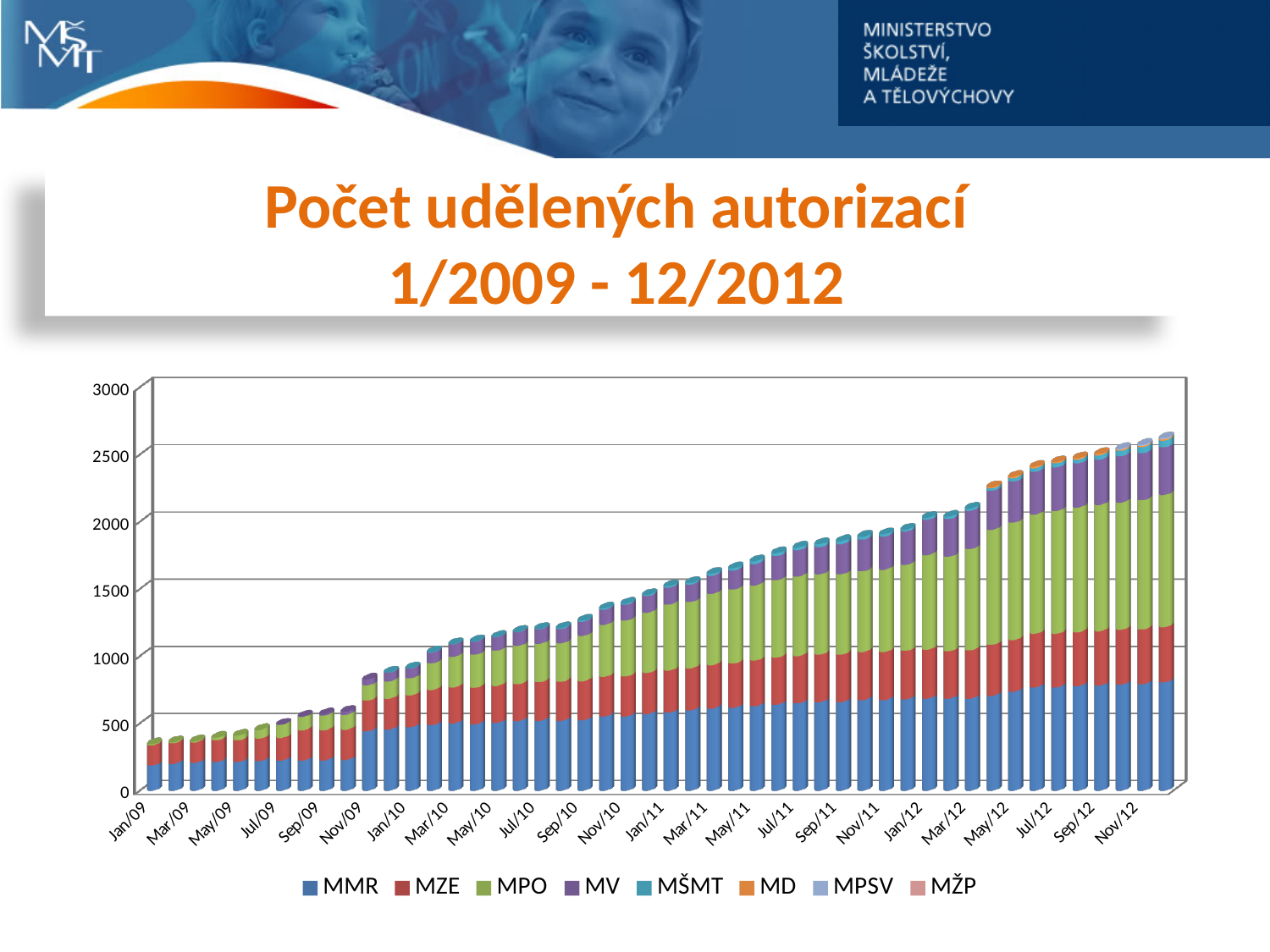
How many series does the legend list? 8 What is the title of the chart? Počet udělených autorizací 1/2009 - 12/2012 Is the total value for Jan/10 greater or less than 1000? less What kind of chart is shown on the slide? stacked bar chart Is the total value for Nov/12 greater or less than 2500? greater Is the total value for Jul/10 greater or less than 1000? greater Which has the larger MMR segment, Jan/09 or Nov/12? Nov/12 Which has the larger total, Jan/09 or Nov/12? Nov/12 Which series is listed first in the legend? MMR Do the total bar heights rise or fall from Jan/09 to Nov/12? rise